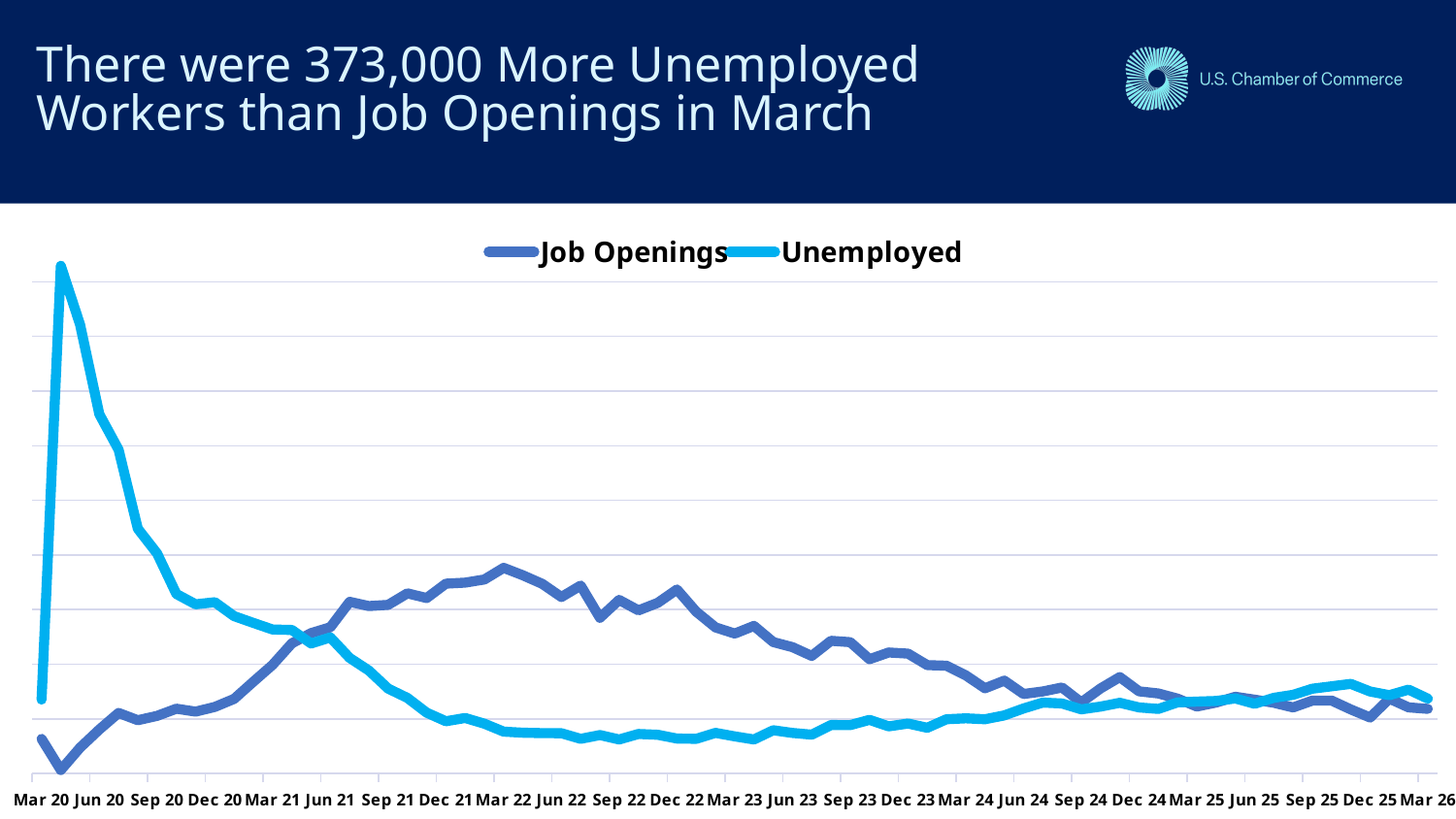
Which series reaches the highest point anywhere on the chart? Unemployed According to the slide title, how many more unemployed workers than job openings were there in March? 373,000 At Dec 23, which series is higher, Job Openings or Unemployed? Job Openings At Jun 20, which series is higher, Job Openings or Unemployed? Unemployed What are the two series named in the legend? Job Openings and Unemployed At Mar 22, which series is higher, Job Openings or Unemployed? Job Openings How many series does the legend list? 2 Does the Job Openings line generally rise or fall between Mar 20 and Mar 22? rise Does the Unemployed line generally rise or fall between Jun 20 and Mar 22? fall Does the Job Openings line generally rise or fall between Mar 22 and Mar 26? fall What kind of chart is shown on the slide? line chart